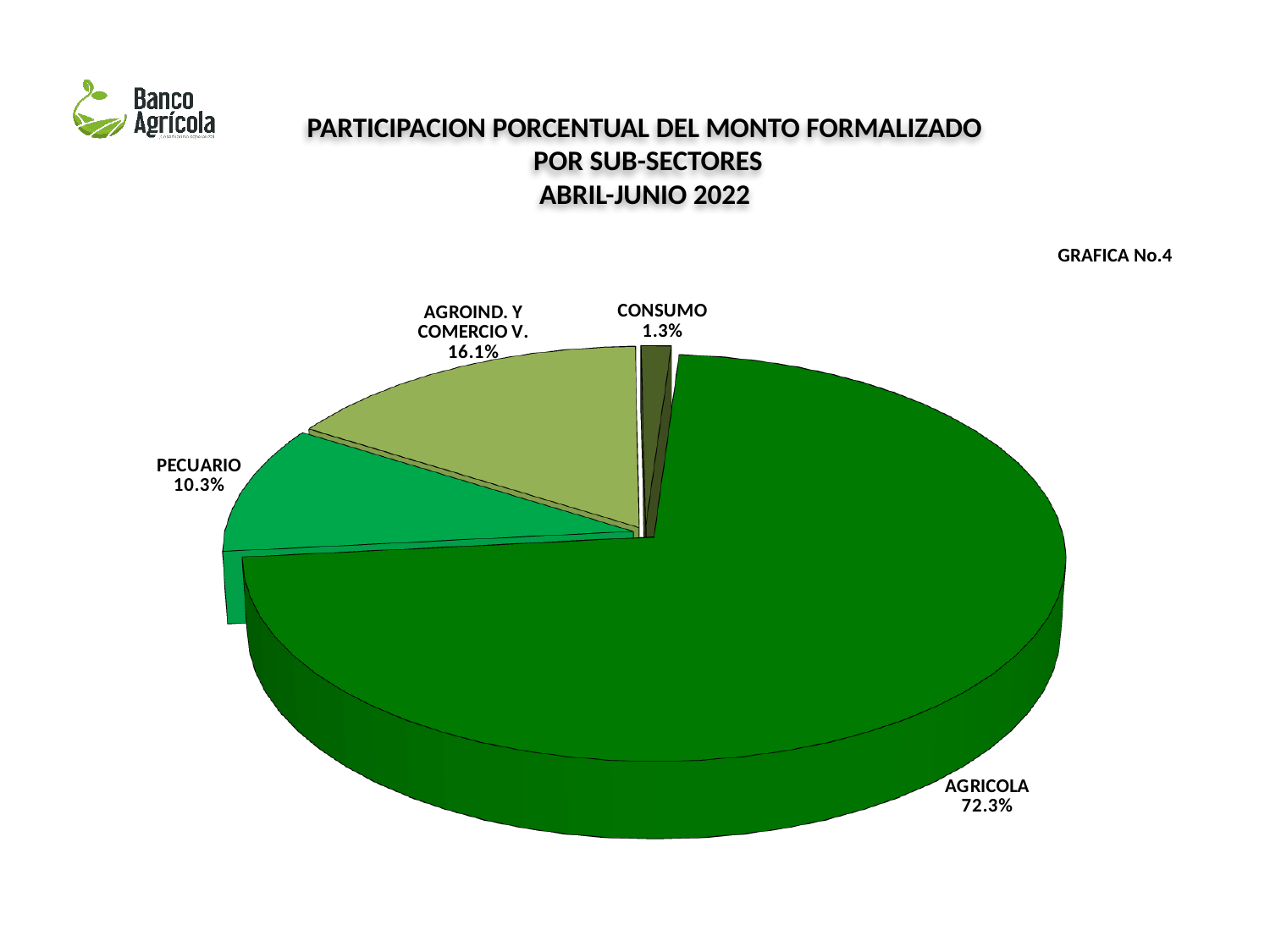
What kind of chart is shown on the slide? Pie chart What is the value shown for CONSUMO? 1.3% What is the value shown for PECUARIO? 10.3% Which sub-sector has the largest share of the pie? AGRICOLA What is the difference in percentage points between AGRICOLA and AGROIND. Y COMERCIO V.? 56.2 Which sub-sector has the smallest share of the pie? CONSUMO What share of the pie does AGRICOLA represent? 72.3% What is the value shown for AGROIND. Y COMERCIO V.? 16.1% How many sub-sectors (slices) are shown in the pie chart? 4 What period does the chart title say the data covers? ABRIL-JUNIO 2022 What is the difference in percentage points between AGROIND. Y COMERCIO V. and PECUARIO? 5.8 Which is larger, the share for PECUARIO or the share for AGROIND. Y COMERCIO V.? AGROIND. Y COMERCIO V.